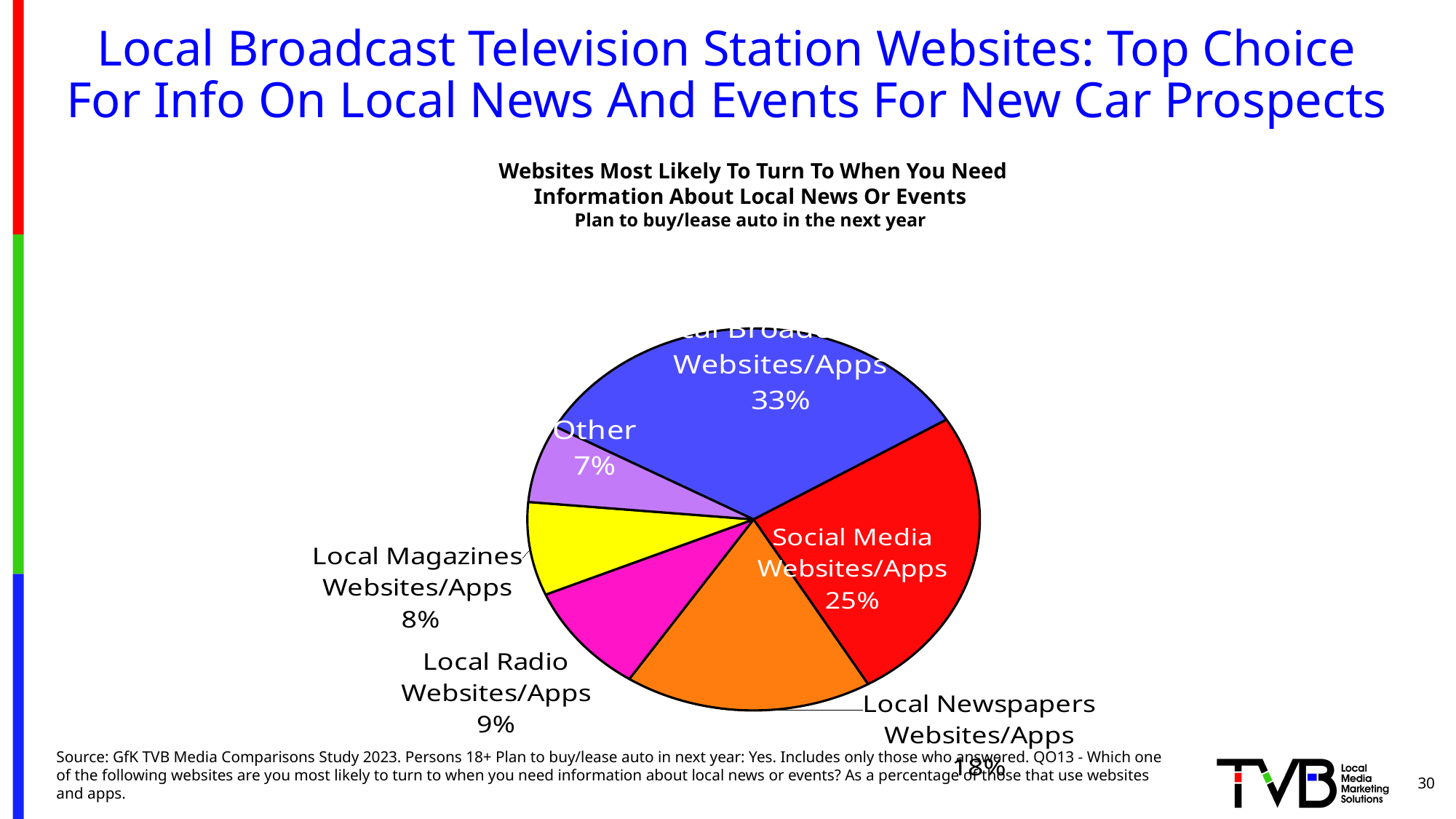
What kind of chart is shown on the slide? pie chart What share of the pie does the Other slice represent? 7% What percentage of the pie is Local Radio Websites/Apps? 9% What is the value of the largest slice in the pie chart? 33% Which slice of the pie chart is the smallest? Other What percentage of the pie is Local Magazines Websites/Apps? 8% What colour is the Social Media Websites/Apps slice? red How many slices does the pie chart have? 6 Which is larger, Local Radio Websites/Apps or Local Magazines Websites/Apps? Local Radio Websites/Apps What percentage of the pie is Local Newspapers Websites/Apps? 18% What is the difference in percentage points between Social Media Websites/Apps and Local Newspapers Websites/Apps? 7 percentage points What percentage of the pie is Social Media Websites/Apps? 25%